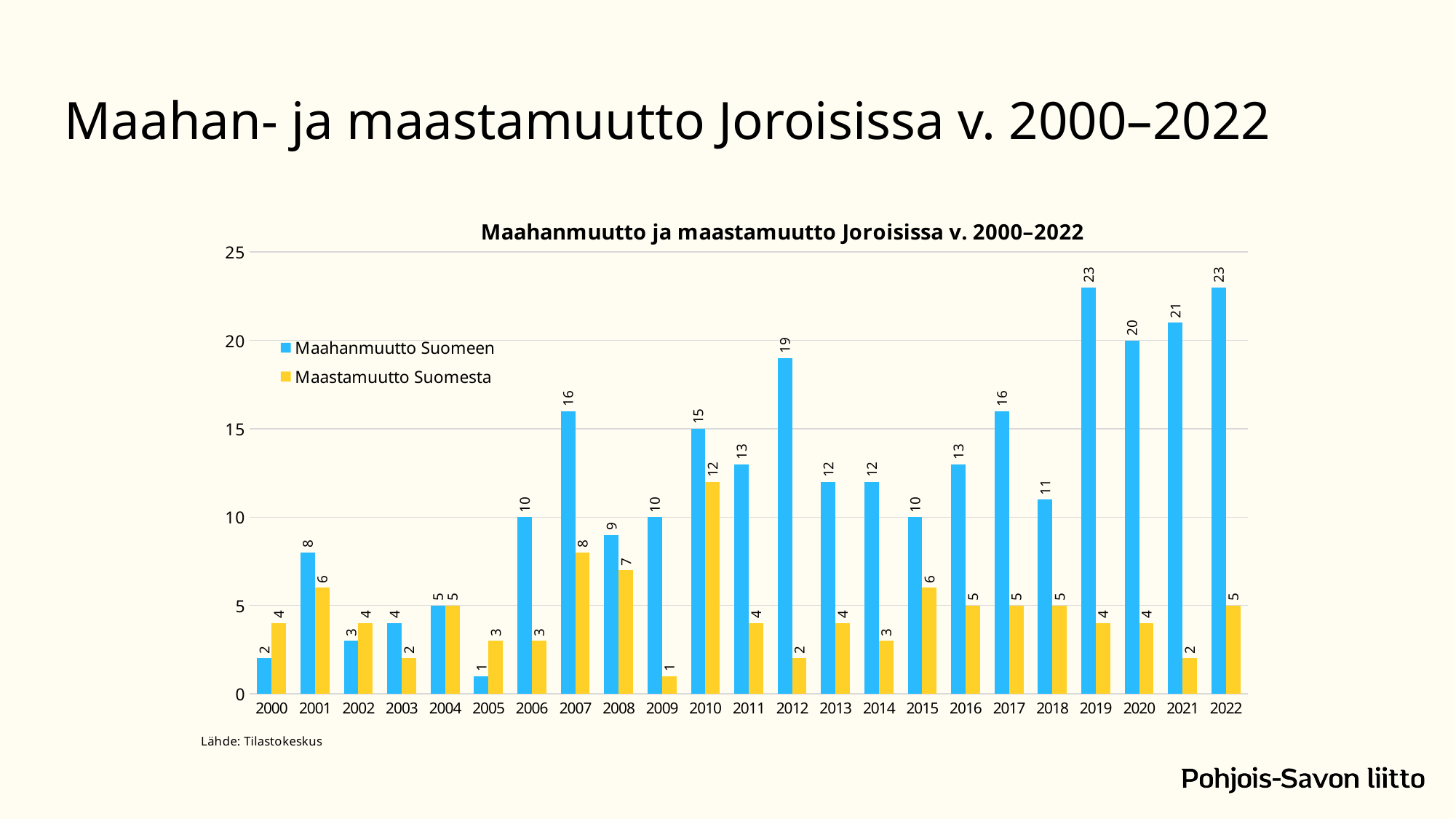
What is the difference between Maahanmuutto Suomeen and Maastamuutto Suomesta in 2019? 19 What is the value of Maahanmuutto Suomeen for 2012? 19 In which year is Maahanmuutto Suomeen lowest? 2005 What is the value of Maahanmuutto Suomeen for 2020? 20 Which is larger in 2000, Maahanmuutto Suomeen or Maastamuutto Suomesta? Maastamuutto Suomesta How many series does the legend list? 2 What kind of chart is shown on the slide? Bar chart In which year is Maastamuutto Suomesta lowest? 2009 How many years are shown on the x axis? 23 In which year is Maastamuutto Suomesta highest? 2010 What is the value of Maastamuutto Suomesta for 2010? 12 What colour are the Maastamuutto Suomesta bars? Yellow